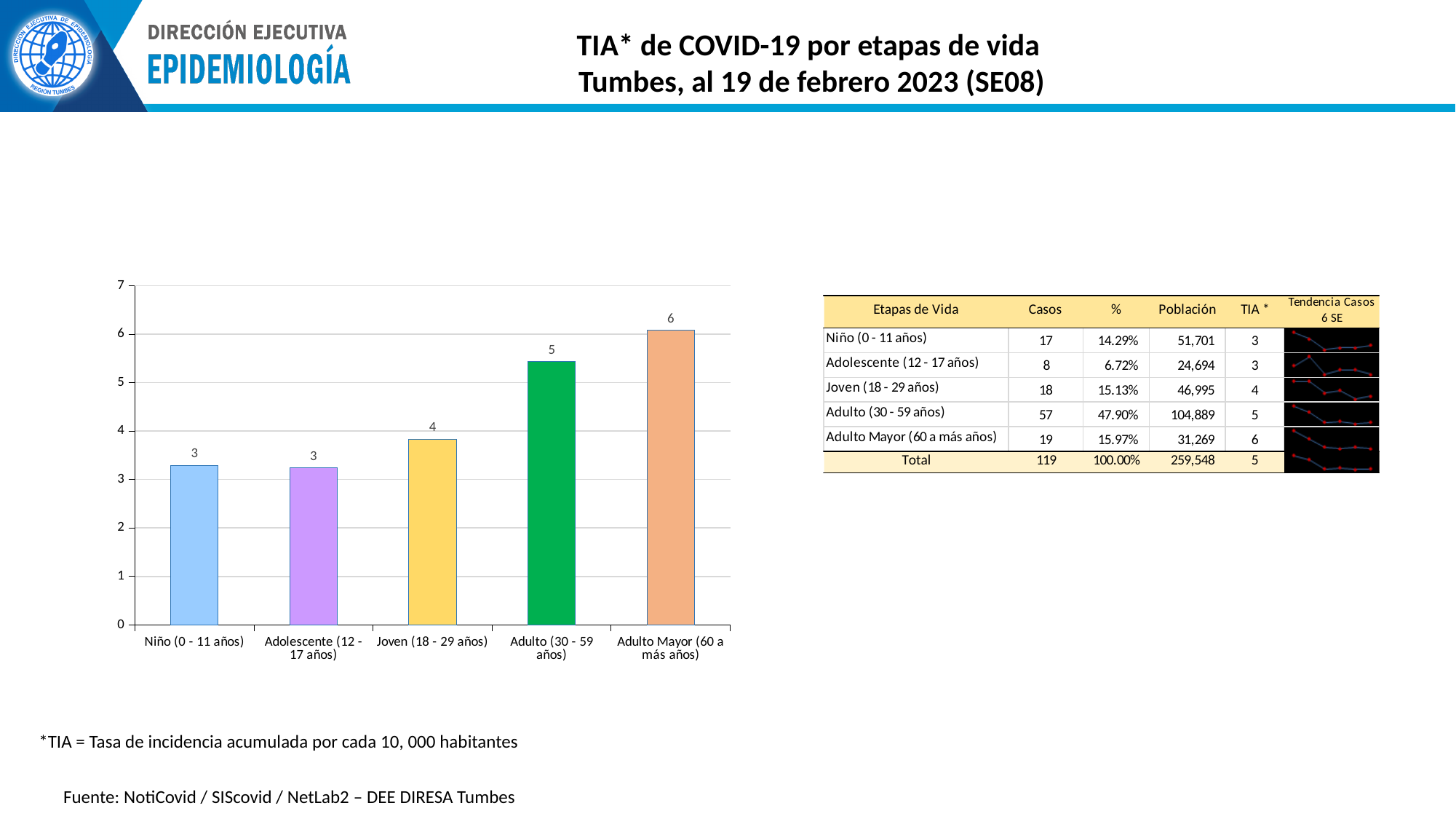
Is the bar for Niño (0 - 11 años) greater or less than 4? less What is the TIA value shown for Adulto Mayor (60 a más años) in the bar chart? 6 Which life stage has the highest TIA value in the bar chart? Adulto Mayor (60 a más años) Which has a larger TIA value, Adulto (30 - 59 años) or Joven (18 - 29 años)? Adulto (30 - 59 años) Do the TIA values rise or fall moving from Niño to Adulto Mayor along the x axis? rise What is the TIA value shown for Joven (18 - 29 años) in the bar chart? 4 What is the TIA value shown for Niño (0 - 11 años) in the bar chart? 3 What kind of chart is used to show the TIA by life stage? bar chart Is the bar for Adulto Mayor (60 a más años) greater or less than 5? greater What is the difference between the TIA values for Adulto Mayor (60 a más años) and Niño (0 - 11 años)? 3 How many life-stage categories are shown in the bar chart? 5 What is the TIA value shown for Adulto (30 - 59 años) in the bar chart? 5